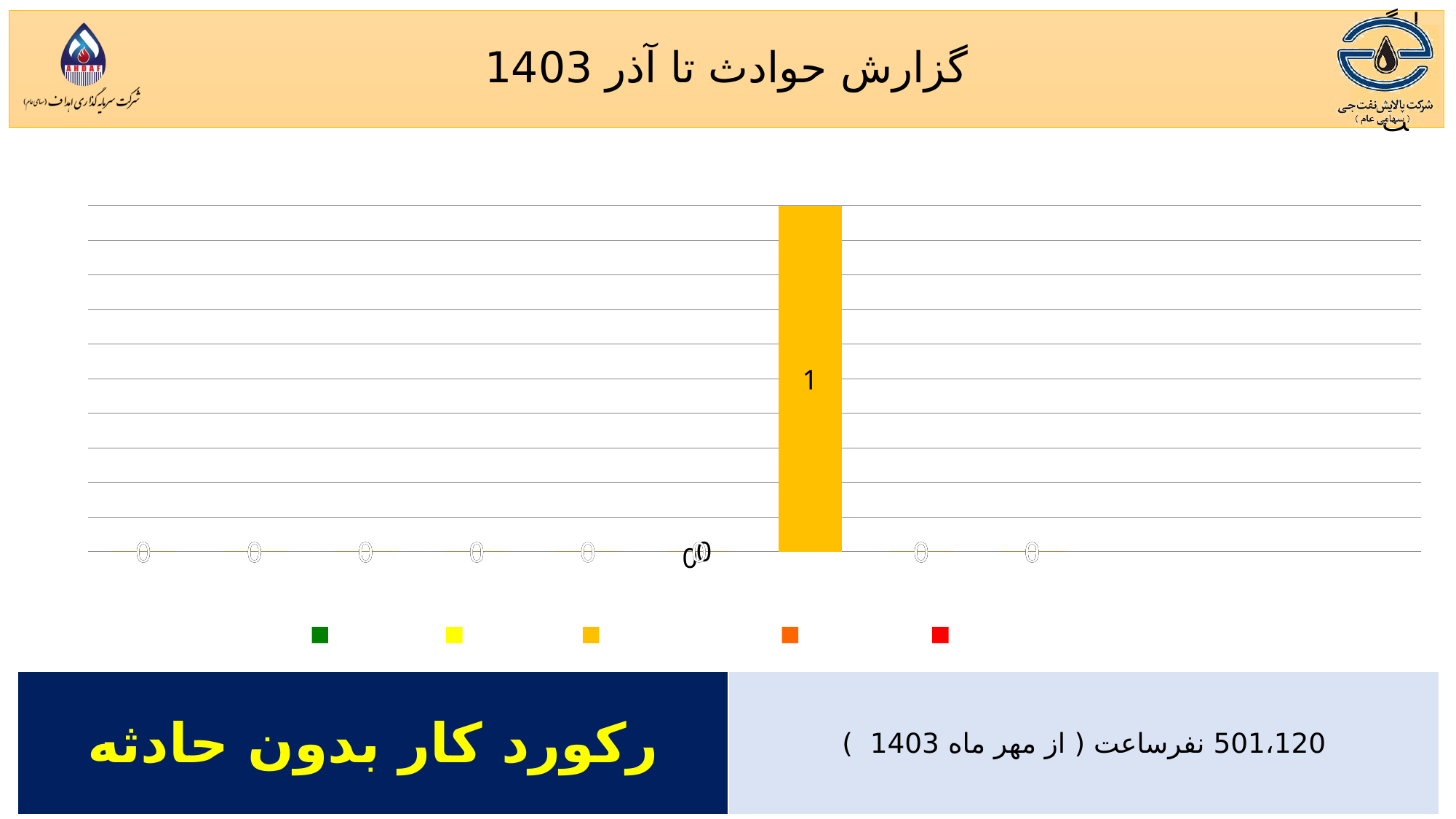
What is the value printed on the tallest bar in the chart? 1 What colour is the only visible bar in the chart? yellow-orange How many bars in the chart have a visible height greater than zero? 1 How many coloured legend squares are shown below the chart? 5 What kind of chart is shown on the slide? bar chart Is the value of the tallest bar greater or less than 0? greater What is the highest value shown by a data label in the chart? 1